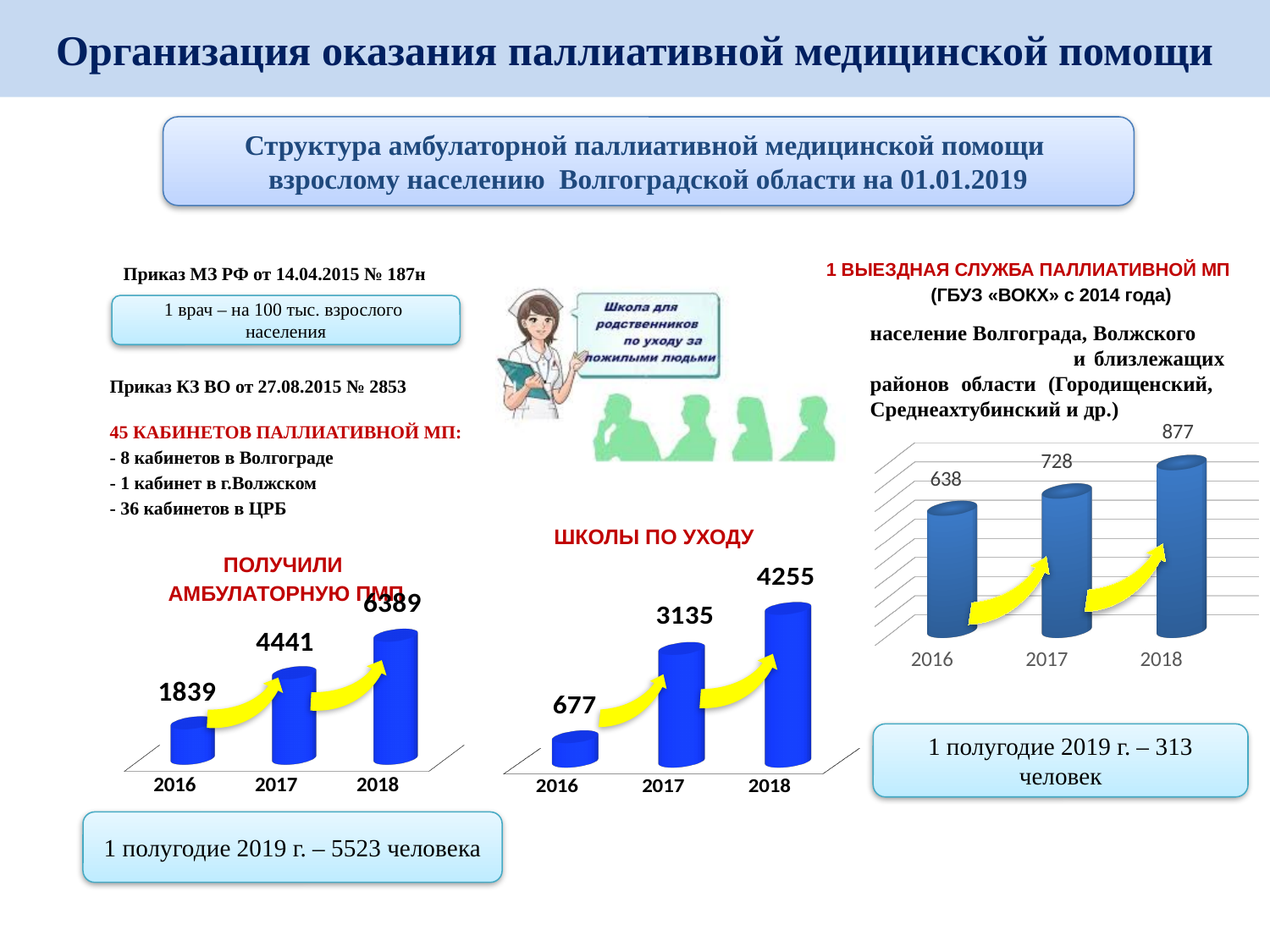
In the chart titled «ШКОЛЫ ПО УХОДУ», do the values rise or fall from 2016 to 2018? rise In the chart on the right of the slide (under «1 ВЫЕЗДНАЯ СЛУЖБА ПАЛЛИАТИВНОЙ МП»), how many years are shown? 3 What type of chart is the chart titled «ШКОЛЫ ПО УХОДУ»? bar chart In the chart on the right of the slide (under «1 ВЫЕЗДНАЯ СЛУЖБА ПАЛЛИАТИВНОЙ МП»), what is the difference between the 2018 and 2016 values? 239 In the chart titled «ШКОЛЫ ПО УХОДУ», what is the difference between the 2018 and 2017 values? 1120 In the chart titled «ШКОЛЫ ПО УХОДУ», what is the value for 2016? 677 In the chart titled «ПОЛУЧИЛИ АМБУЛАТОРНУЮ ПМП», what is the difference between the 2018 and 2016 values? 4550 In the chart titled «ПОЛУЧИЛИ АМБУЛАТОРНУЮ ПМП», which year has the highest value? 2018 In the chart titled «ШКОЛЫ ПО УХОДУ», which year has the lowest value? 2016 In the chart on the right of the slide (under «1 ВЫЕЗДНАЯ СЛУЖБА ПАЛЛИАТИВНОЙ МП»), what is the value for 2017? 728 In the chart titled «ПОЛУЧИЛИ АМБУЛАТОРНУЮ ПМП», what is the value for 2017? 4441 Which is larger: the 2016 value in the chart «ПОЛУЧИЛИ АМБУЛАТОРНУЮ ПМП» or the 2016 value in the chart «ШКОЛЫ ПО УХОДУ»? «ПОЛУЧИЛИ АМБУЛАТОРНУЮ ПМП» (1839)